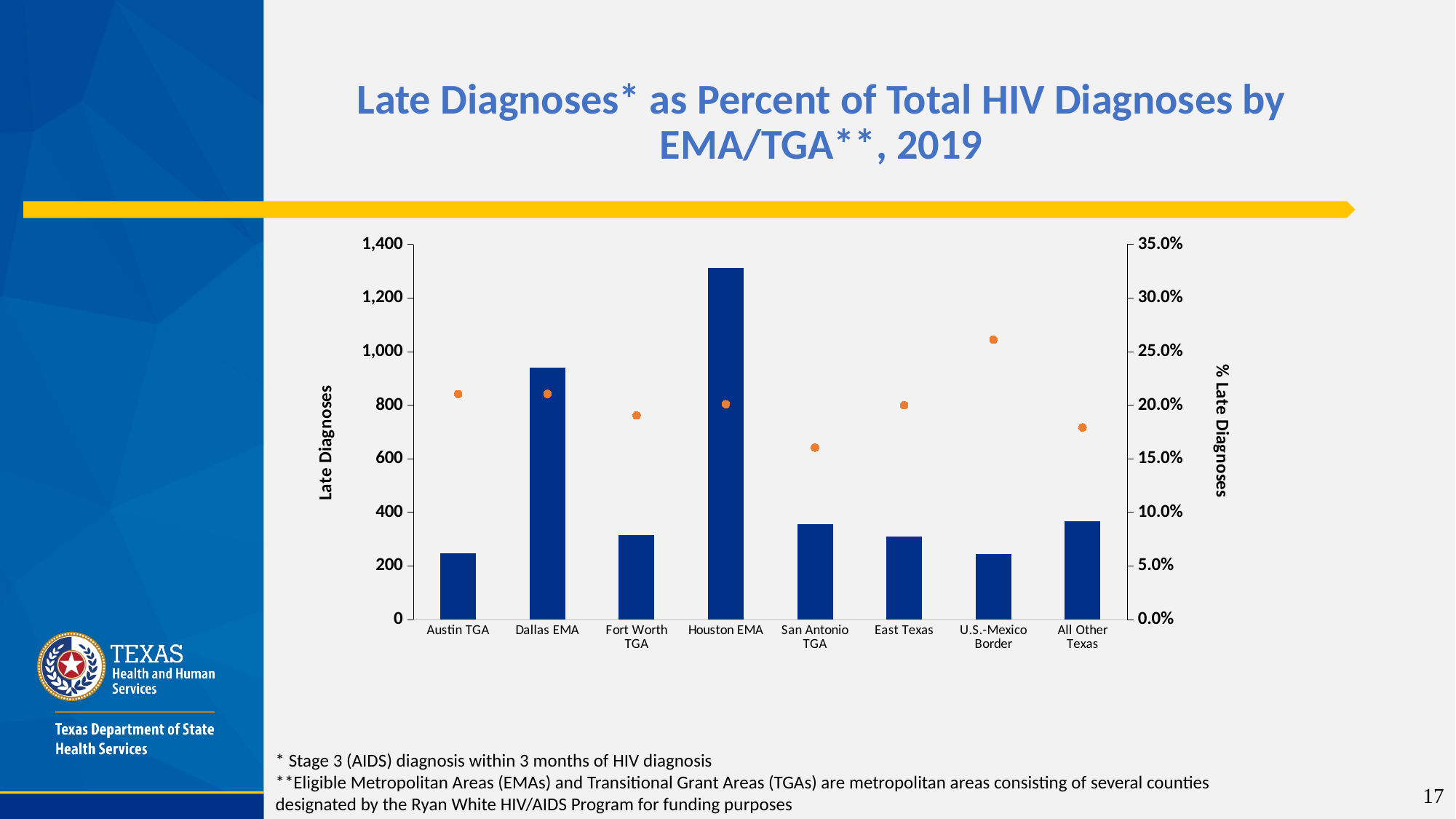
Is the percent of late diagnoses for U.S.-Mexico Border greater or less than 25.0%? greater Which has more late diagnoses, Dallas EMA or Fort Worth TGA? Dallas EMA What type of chart is shown on the slide? Combination chart with bars and dot markers (bar and line chart) Is the number of late diagnoses for Dallas EMA greater or less than 1,000? less Is the percent of late diagnoses for San Antonio TGA greater or less than 20.0%? less How many EMA/TGA categories are shown on the x axis? 8 What is the label of the right vertical axis? % Late Diagnoses Which category has the lowest percent of late diagnoses (orange dot)? San Antonio TGA Which category has the highest percent of late diagnoses (orange dot)? U.S.-Mexico Border Which category has the highest number of late diagnoses (tallest bar)? Houston EMA What is the label of the left vertical axis? Late Diagnoses